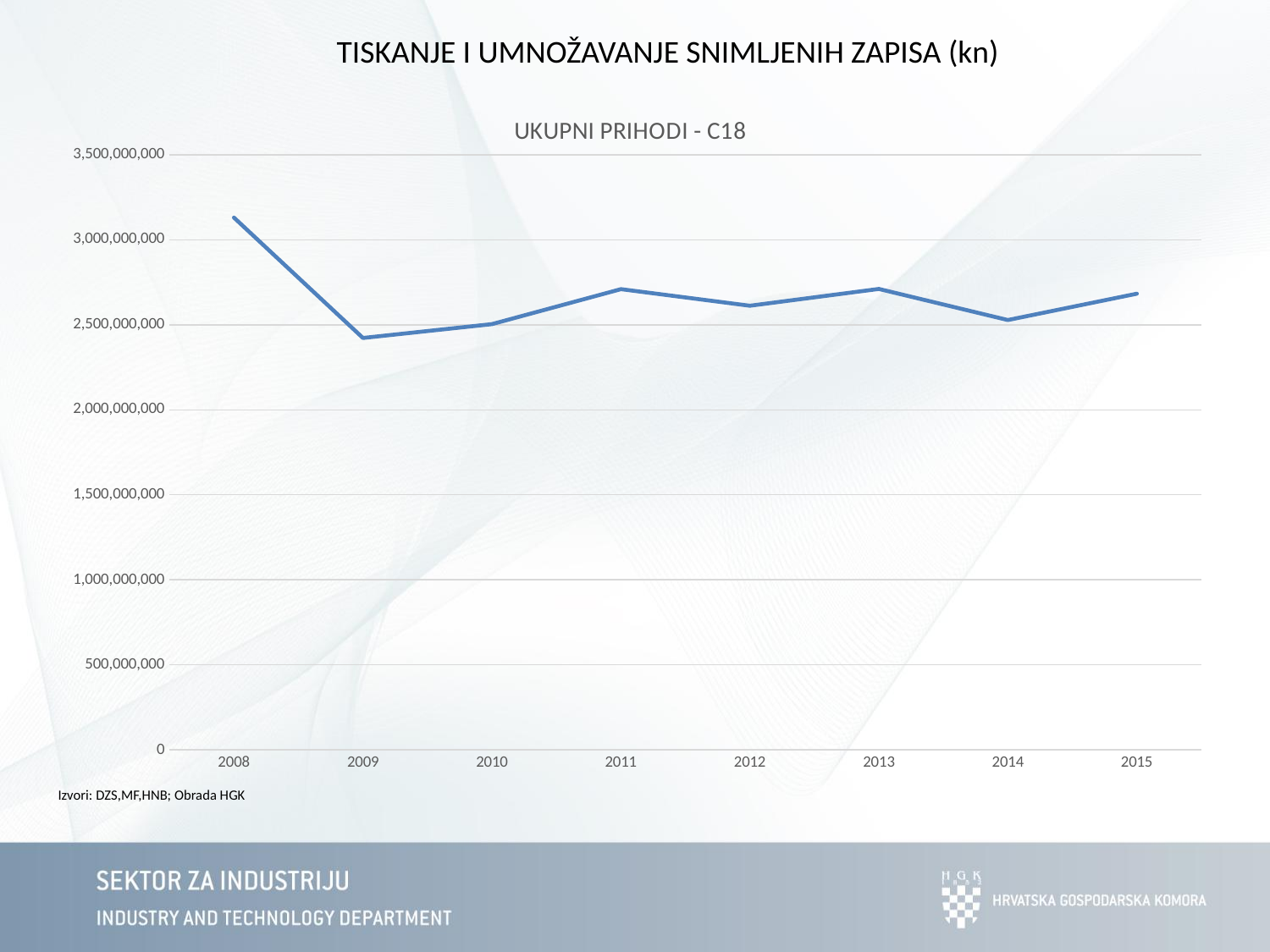
What kind of chart is shown on the slide? line chart Which is larger, the value for 2011 or the value for 2014? 2011 What is the title of the chart? UKUPNI PRIHODI - C18 Which year has the lowest value? 2009 Which is larger, the value for 2008 or the value for 2009? 2008 Is the value for 2011 greater or less than 2,500,000,000? greater Is the value for 2013 greater or less than 3,000,000,000? less Is the value for 2009 greater or less than 2,500,000,000? less Which year has the highest value? 2008 Does the value rise or fall from 2008 to 2009? fall How many years are plotted on the x axis? 8